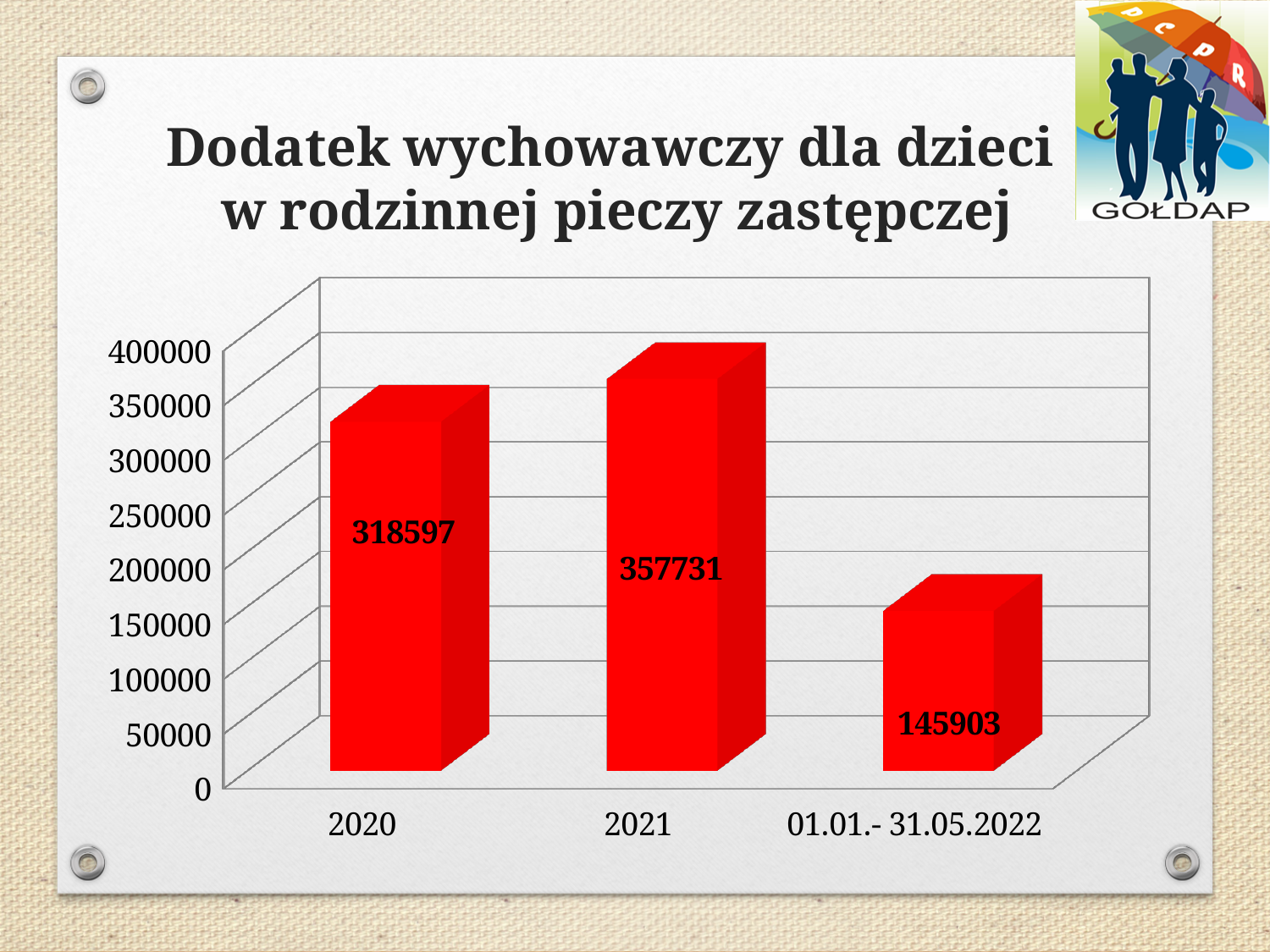
Which is larger, the value for 2020 or the value for 2021? 2021 Is the value for 01.01.- 31.05.2022 greater or less than 200000? less What is the difference between the values for 2020 and 01.01.- 31.05.2022? 172694 What is the value for 01.01.- 31.05.2022? 145903 What is the value for 2021? 357731 What is the value for 2020? 318597 Does the value rise or fall from 2021 to 01.01.- 31.05.2022? fall What is the difference between the values for 2021 and 2020? 39134 How many categories are shown on the x axis? 3 What kind of chart is shown on the slide? bar chart Which category has the lowest value? 01.01.- 31.05.2022 Which category has the highest value? 2021